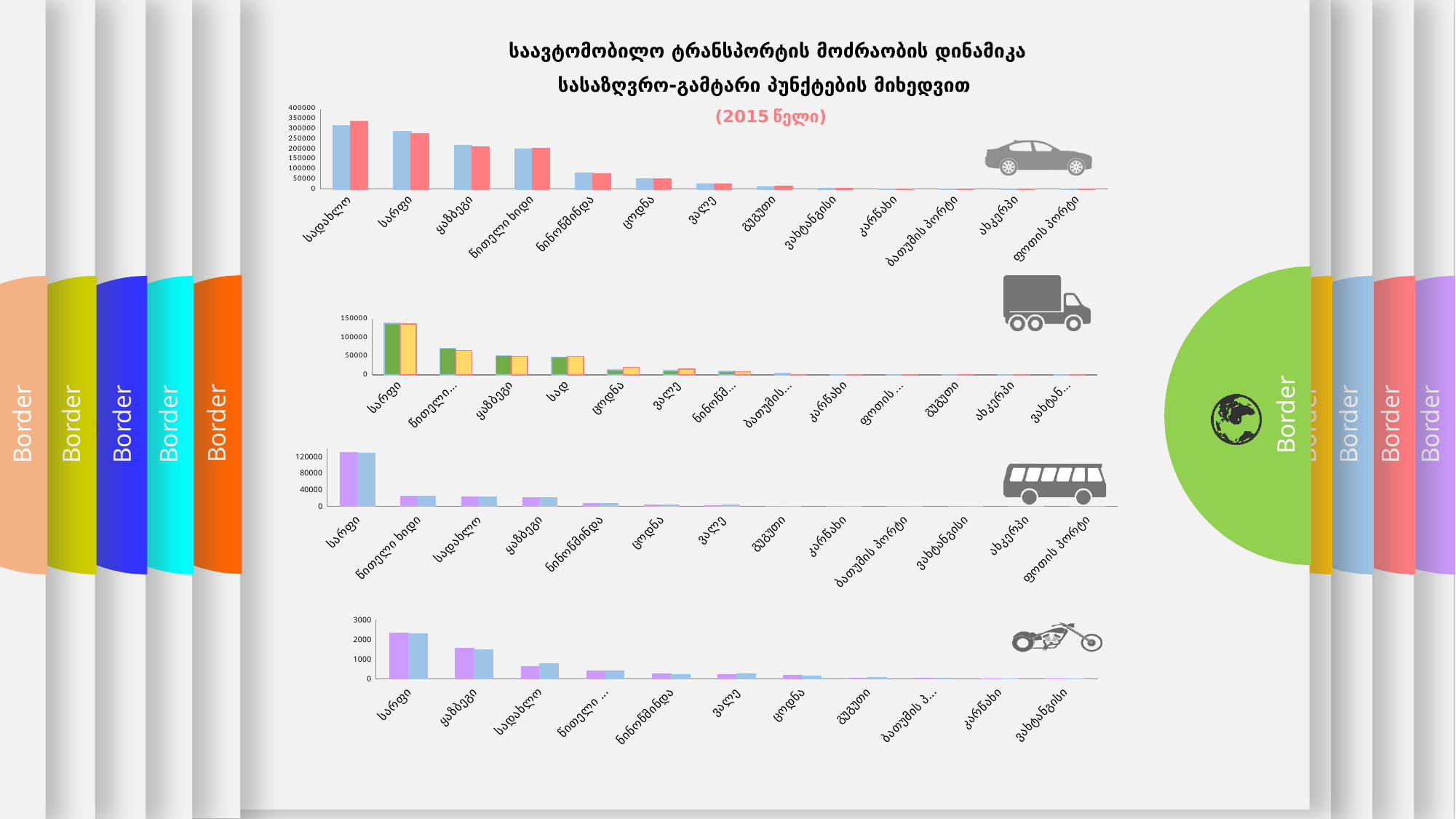
In the bottom chart (motorcycle icon), how many categories are shown on the x axis? 11 In the top chart (car icon), is the red bar for სადახლო greater or less than 300000? greater In the second chart from the top (truck icon), which category has the highest bars? სარფი In the top chart (car icon), is the blue bar for ნინოწმინდა greater or less than 100000? less In the bottom chart (motorcycle icon), do the bar values rise or fall from left to right along the x axis? fall In the top chart (car icon), which is larger: the blue bar for სარფი or the blue bar for ყაზბეგი? სარფი In the third chart from the top (bus icon), is the purple bar for წითელი ხიდი greater or less than 40000? less What kind of chart is the top chart (with the car icon)? bar chart In the top chart (car icon), which category has the highest bars? სადახლო In the top chart (car icon), how many categories are shown on the x axis? 13